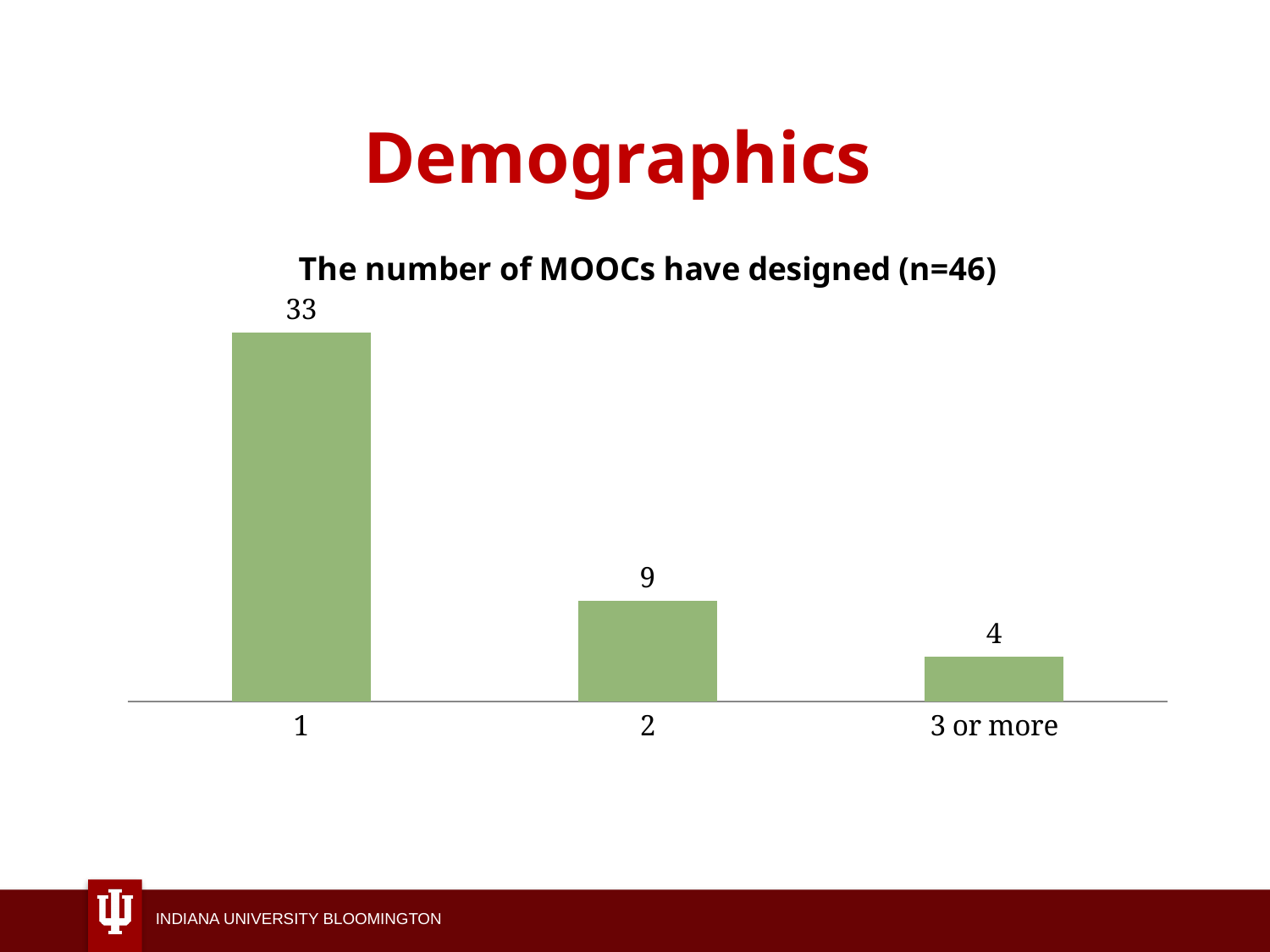
What is the value for the category "3 or more"? 4 What is the value for the category "1"? 33 Which is larger, the value for "2" or the value for "3 or more"? 2 Which category has the highest value? 1 What is the title of the chart? The number of MOOCs have designed (n=46) What is the difference between the values for "1" and "2"? 24 What is the value for the category "2"? 9 Which category has the lowest value? 3 or more Do the values rise or fall from left to right along the x axis? Fall What kind of chart is shown on the slide? Bar chart What is the difference between the values for "2" and "3 or more"? 5 How many categories are shown on the x axis? 3